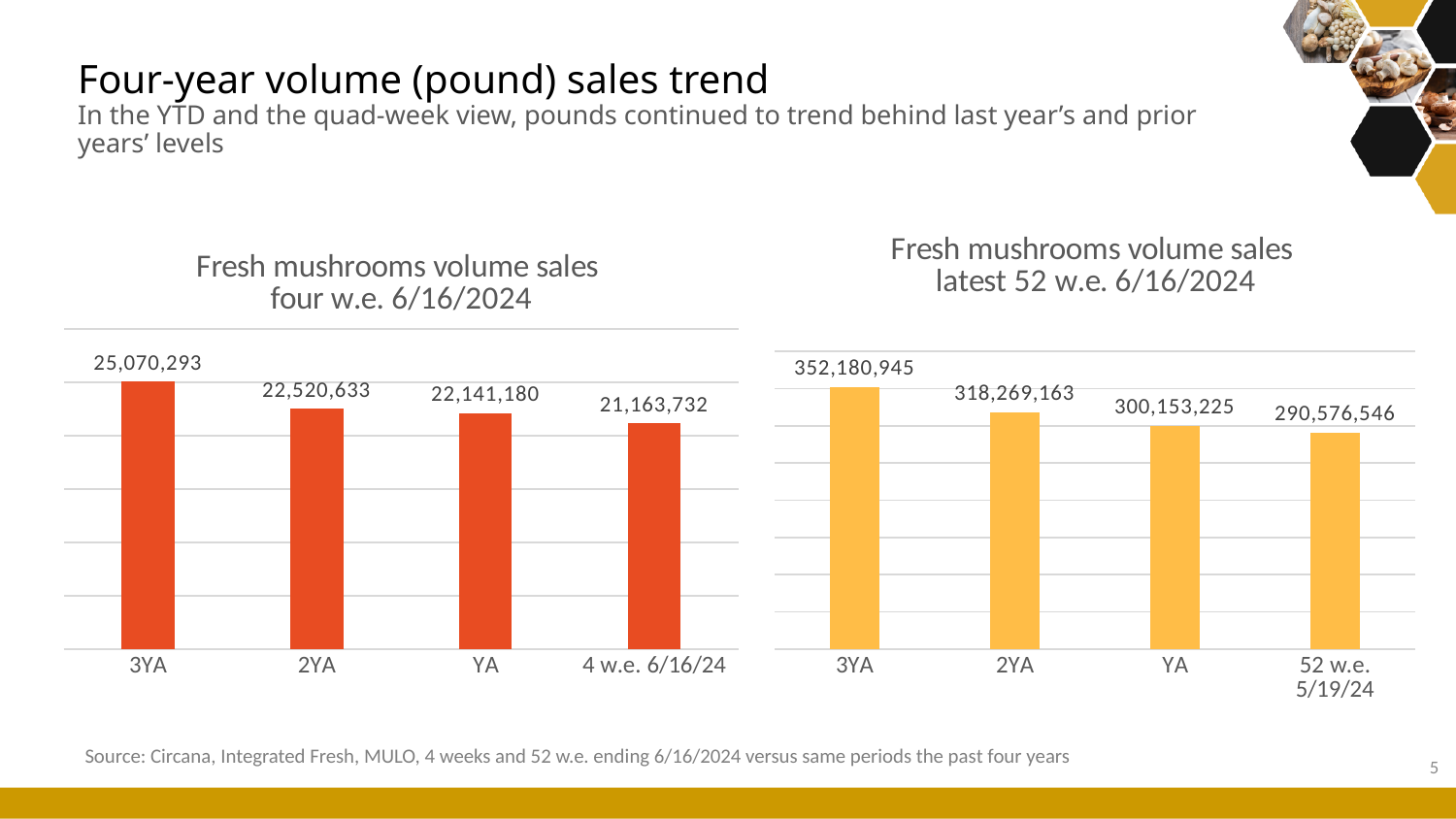
In the 'Fresh mushrooms volume sales latest 52 w.e. 6/16/2024' chart, which category has the lowest value? 52 w.e. 5/19/24 In the 'Fresh mushrooms volume sales four w.e. 6/16/2024' chart, what is the value for 4 w.e. 6/16/24? 21,163,732 What type of chart is the 'Fresh mushrooms volume sales four w.e. 6/16/2024' chart? Bar chart In the 'Fresh mushrooms volume sales four w.e. 6/16/2024' chart, what is the value for 3YA? 25,070,293 In the 'Fresh mushrooms volume sales latest 52 w.e. 6/16/2024' chart, do the values rise or fall from 3YA to 52 w.e. 5/19/24? Fall In the 'Fresh mushrooms volume sales four w.e. 6/16/2024' chart, which is larger, the value for 2YA or the value for YA? 2YA In the 'Fresh mushrooms volume sales latest 52 w.e. 6/16/2024' chart, what is the value for 52 w.e. 5/19/24? 290,576,546 In the 'Fresh mushrooms volume sales latest 52 w.e. 6/16/2024' chart, what is the difference between the 2YA value and the YA value? 18,115,938 In the 'Fresh mushrooms volume sales four w.e. 6/16/2024' chart, which category has the highest value? 3YA In the 'Fresh mushrooms volume sales four w.e. 6/16/2024' chart, what is the difference between the 3YA value and the 4 w.e. 6/16/24 value? 3,906,561 In the 'Fresh mushrooms volume sales latest 52 w.e. 6/16/2024' chart, what is the value for 2YA? 318,269,163 How many categories are shown in the 'Fresh mushrooms volume sales latest 52 w.e. 6/16/2024' chart? 4